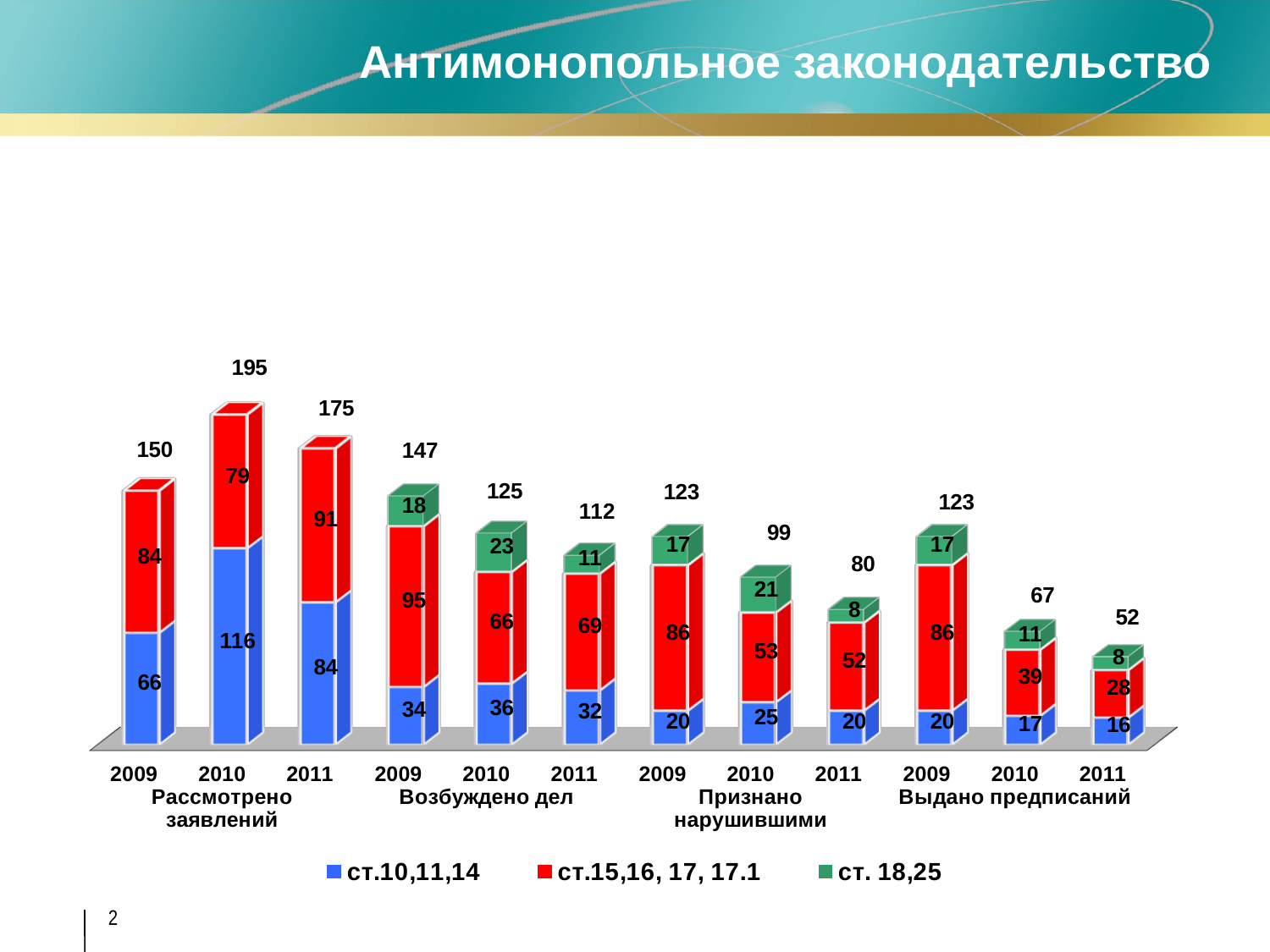
What is the total of the stacked bar for 2009 under Признано нарушившими? 123 How many stacked bars are plotted on the chart? 12 What is the value for ст.10,11,14 in 2010 under Рассмотрено заявлений? 116 What is the total of the stacked bar for 2011 under Выдано предписаний? 52 What is the value for ст. 18,25 in 2010 under Возбуждено дел? 23 Which is larger: the ст.15,16, 17, 17.1 value for 2009 under Возбуждено дел or for 2009 under Признано нарушившими? 2009 under Возбуждено дел (95) What is the difference between the totals for 2009 and 2011 under Возбуждено дел? 35 Which bar has the highest total on the chart? 2010, Рассмотрено заявлений Do the bar totals rise or fall from 2009 to 2011 under Выдано предписаний? fall How many series does the legend list? 3 What kind of chart is shown on the slide? stacked bar chart Which bar has the lowest total on the chart? 2011, Выдано предписаний